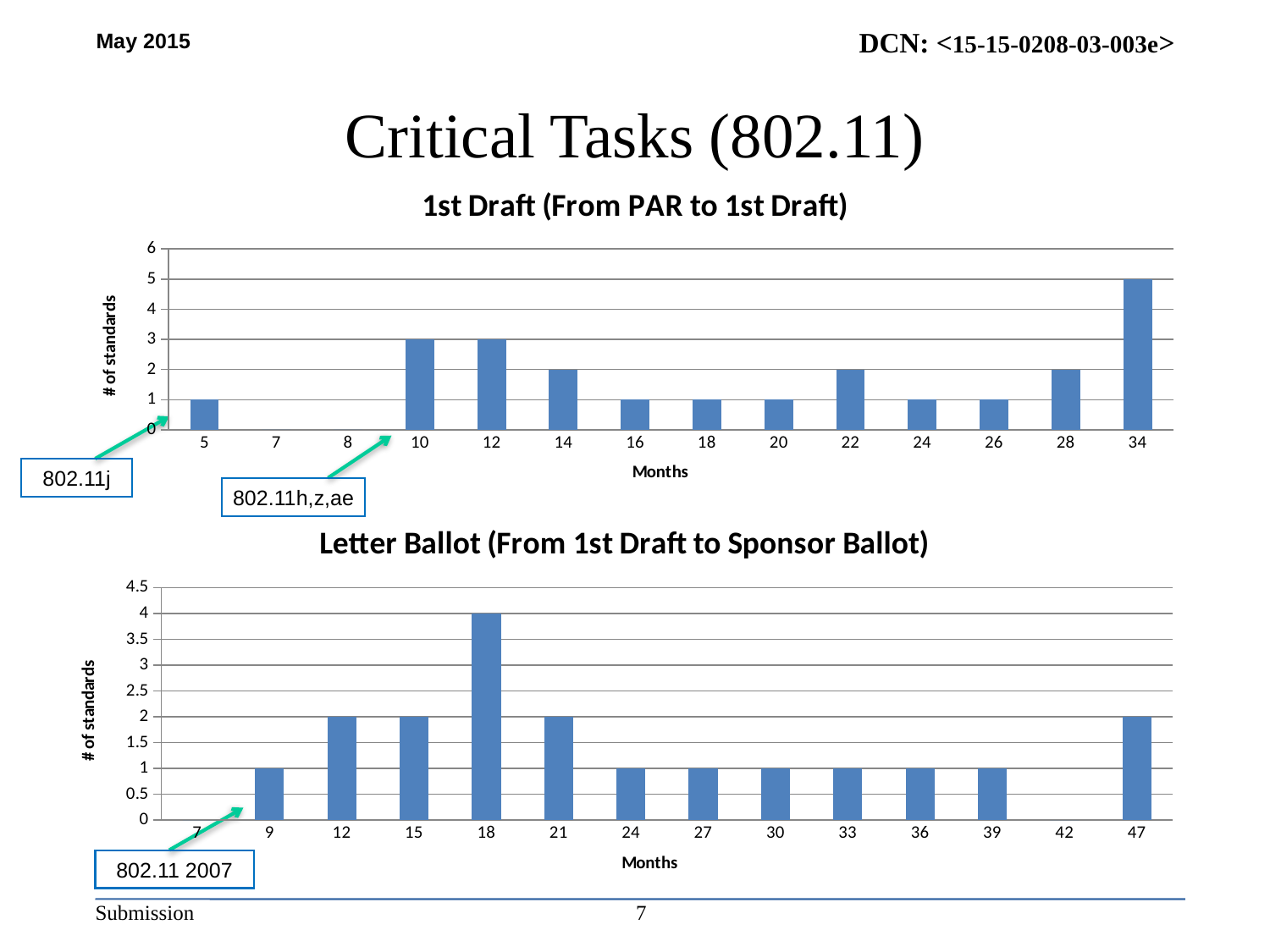
In the 'Letter Ballot (From 1st Draft to Sponsor Ballot)' chart, which month category has the highest number of standards? 18 In the 'Letter Ballot (From 1st Draft to Sponsor Ballot)' chart, what is the label on the x axis? Months In the '1st Draft (From PAR to 1st Draft)' chart, what kind of chart is shown? bar chart In the '1st Draft (From PAR to 1st Draft)' chart, what is the number of standards at 34 months? 5 In the '1st Draft (From PAR to 1st Draft)' chart, what is the label on the y axis? # of standards In the '1st Draft (From PAR to 1st Draft)' chart, what is the number of standards at 10 months? 3 In the 'Letter Ballot (From 1st Draft to Sponsor Ballot)' chart, what is the number of standards at 18 months? 4 In the 'Letter Ballot (From 1st Draft to Sponsor Ballot)' chart, is the number of standards at 12 months larger or smaller than at 24 months? larger In the 'Letter Ballot (From 1st Draft to Sponsor Ballot)' chart, what is the number of standards at 47 months? 2 In the '1st Draft (From PAR to 1st Draft)' chart, how many month categories are shown on the x axis? 14 In the '1st Draft (From PAR to 1st Draft)' chart, what is the difference between the number of standards at 34 months and at 14 months? 3 In the '1st Draft (From PAR to 1st Draft)' chart, which month category has the highest number of standards? 34